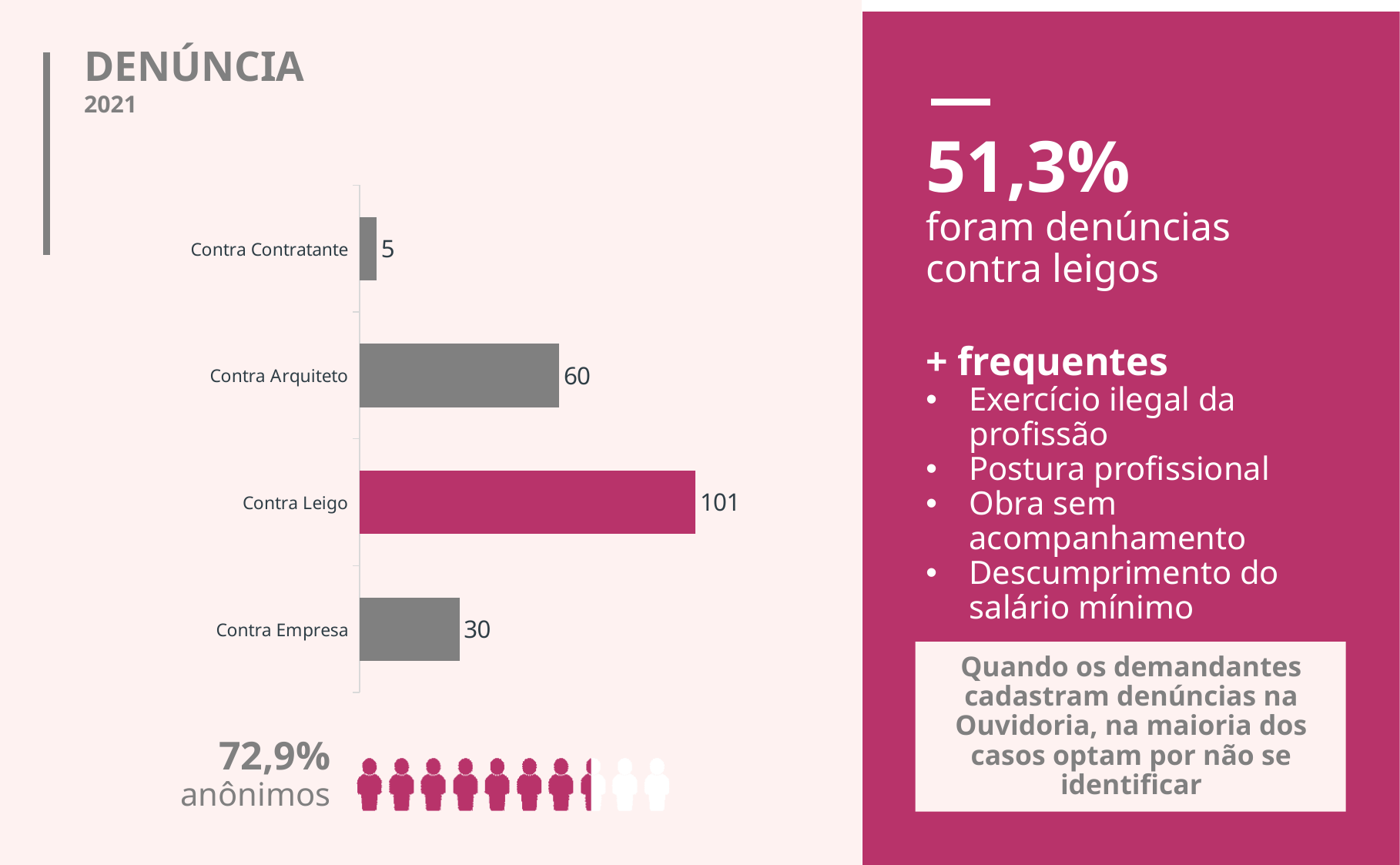
Which bar in the chart is highlighted in a different colour from the others? Contra Leigo How many categories are shown in the chart? 4 Which category has the lowest value? Contra Contratante What is the value for Contra Contratante? 5 What is the value for Contra Leigo? 101 What kind of chart is shown on the slide? Bar chart Which category has the highest value? Contra Leigo What is the value for Contra Arquiteto? 60 What is the value for Contra Empresa? 30 Which is larger, the value for Contra Arquiteto or the value for Contra Empresa? Contra Arquiteto What is the difference between the values for Contra Leigo and Contra Arquiteto? 41 What is the difference between the values for Contra Empresa and Contra Contratante? 25